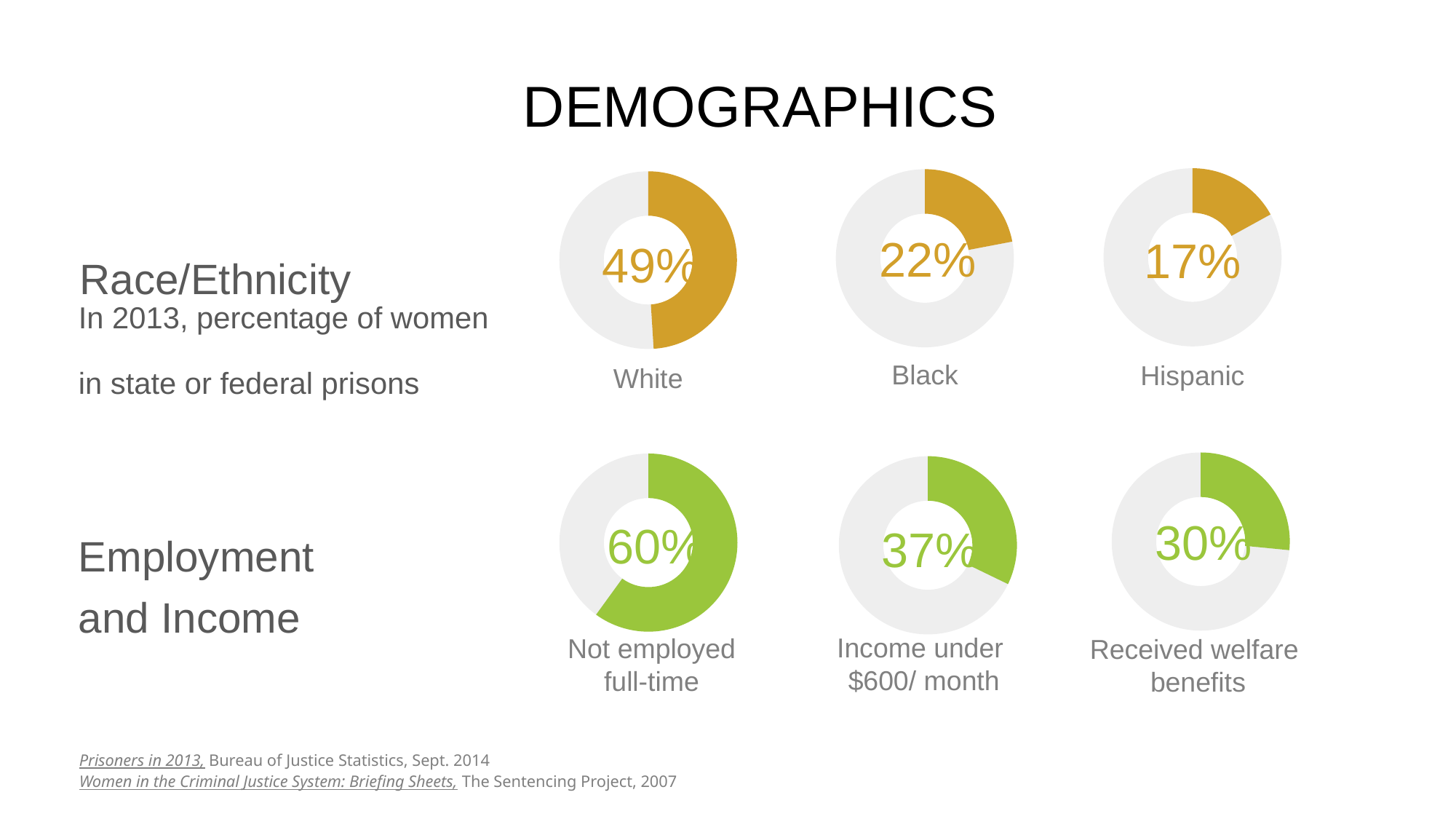
What is the difference between the White and Black percentages in the Race/Ethnicity row? 27% In the Employment and Income row, what percentage is shown for Not employed full-time? 60% In the Race/Ethnicity row, what percentage is shown in the Hispanic donut chart? 17% How many donut charts are shown on the slide in total? 6 In the Employment and Income row, what percentage is shown for Received welfare benefits? 30% In the Race/Ethnicity row, what percentage is shown in the White donut chart? 49% In the Employment and Income row, what percentage is shown for Income under $600/ month? 37% What kind of chart is used to display each percentage on the slide? Donut chart Among the Race/Ethnicity donut charts, which category has the highest percentage? White In the Race/Ethnicity row, what percentage is shown in the Black donut chart? 22% Among the Race/Ethnicity donut charts, which category has the lowest percentage? Hispanic In the Employment and Income row, which is larger: the percentage for Income under $600/ month or for Received welfare benefits? Income under $600/ month